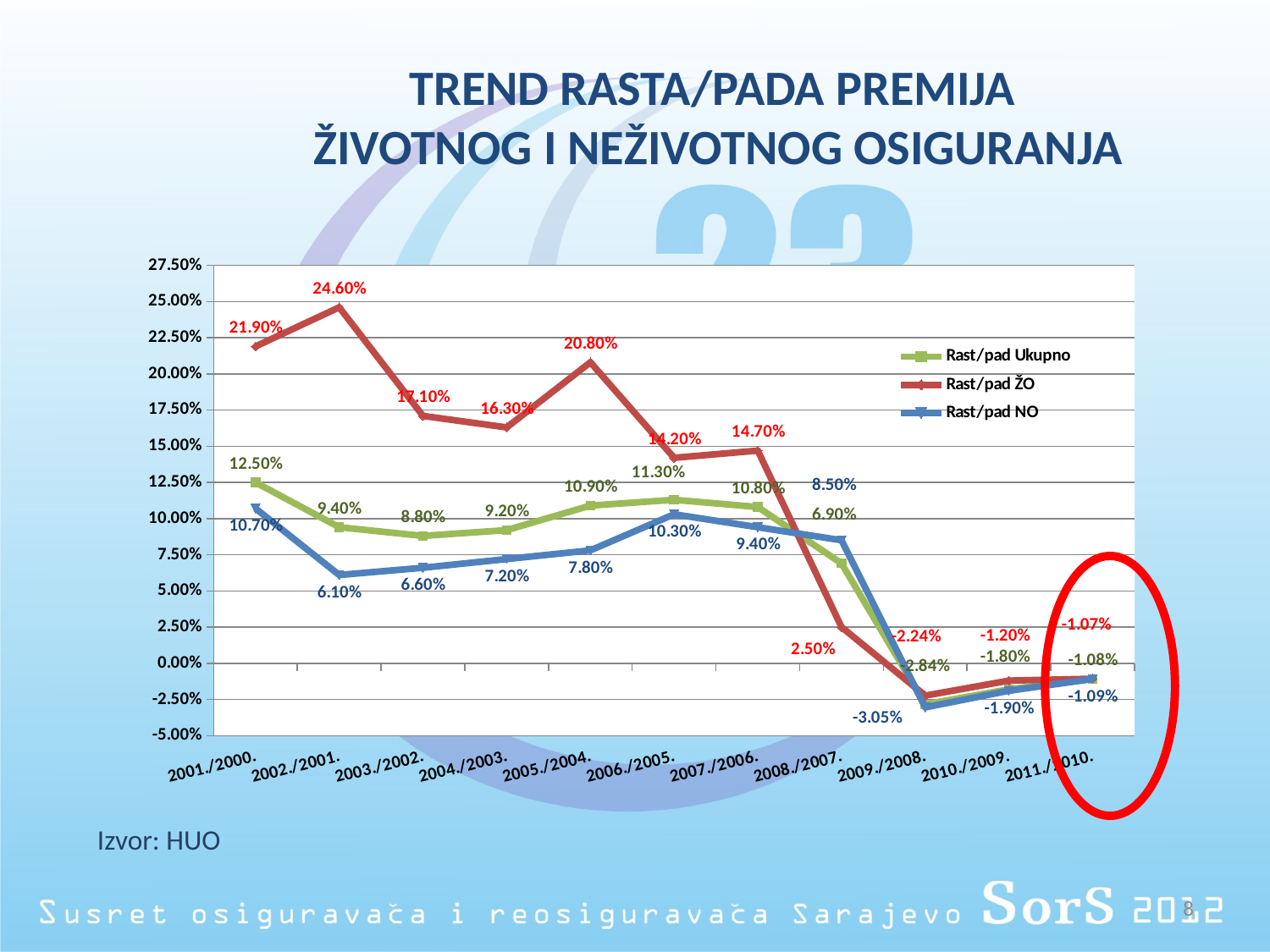
What is the value of Rast/pad ŽO for 2002./2001.? 24.60% In which period is Rast/pad NO lowest? 2009./2008. In which period is Rast/pad ŽO highest? 2002./2001. Which series is drawn in red? Rast/pad ŽO What kind of chart is shown on the slide? line chart How many series does the legend list? 3 How many periods are shown on the x axis? 11 Does Rast/pad ŽO generally rise or fall from 2001./2000. to 2011./2010.? fall Which is larger in 2008./2007., Rast/pad NO or Rast/pad ŽO? Rast/pad NO What is the value of Rast/pad Ukupno for 2006./2005.? 11.30% What is the value of Rast/pad NO for 2009./2008.? -3.05% What is the difference between Rast/pad ŽO and Rast/pad NO in 2001./2000.? 11.20%